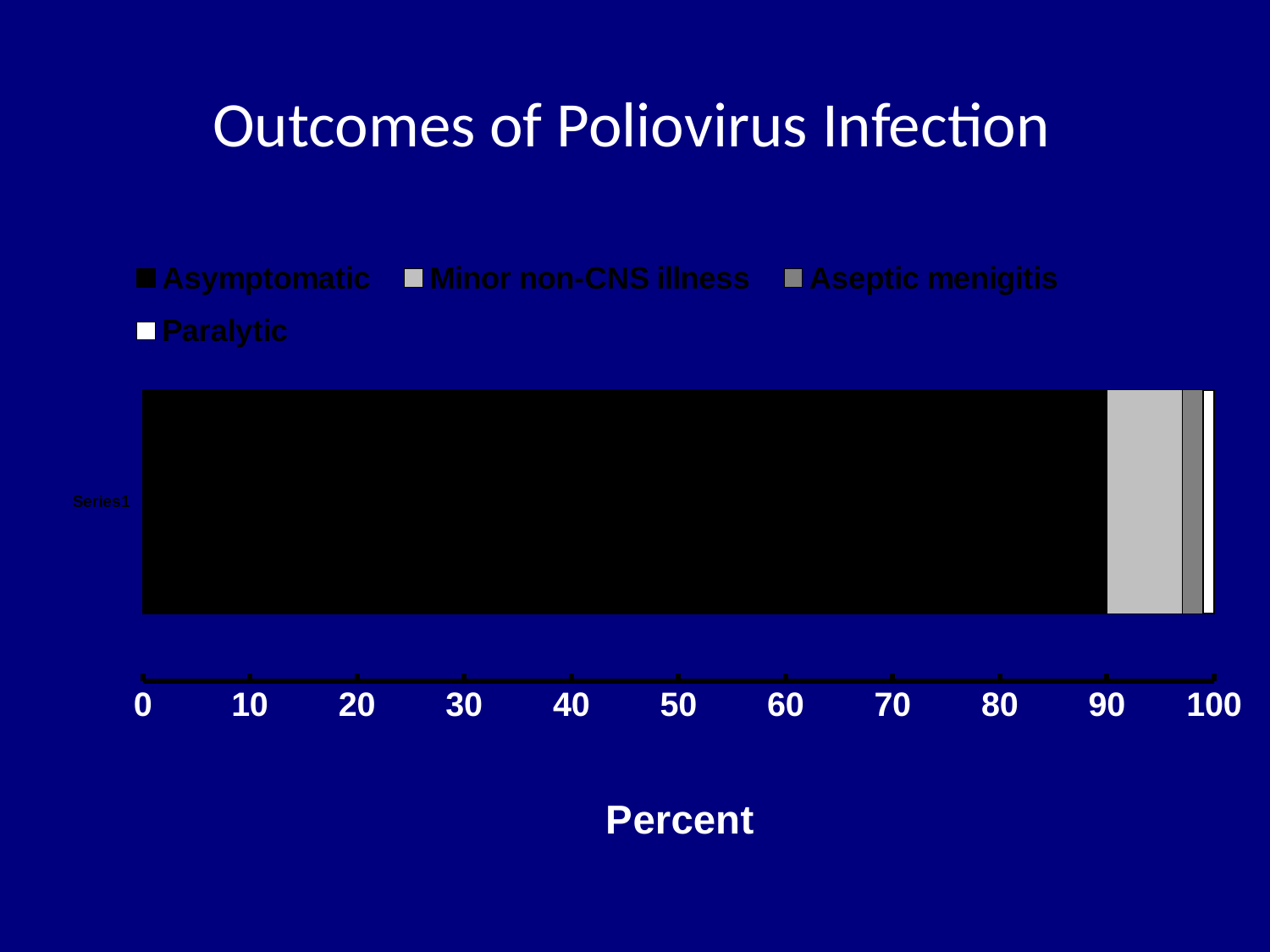
Is the value for Minor non-CNS illness greater or less than 10? less Which outcome takes up the smallest portion of the bar? Paralytic What is the label on the horizontal axis? Percent How many bars are plotted in the chart? 1 What value on the axis does the Asymptomatic segment end at? 90 What is the title of the chart? Outcomes of Poliovirus Infection Is the value for Asymptomatic greater or less than 80? greater What kind of chart is shown on the slide? Stacked bar chart Which is larger, the segment for Minor non-CNS illness or the segment for Aseptic menigitis? Minor non-CNS illness How many series does the legend list? 4 Which outcome takes up the largest portion of the bar? Asymptomatic